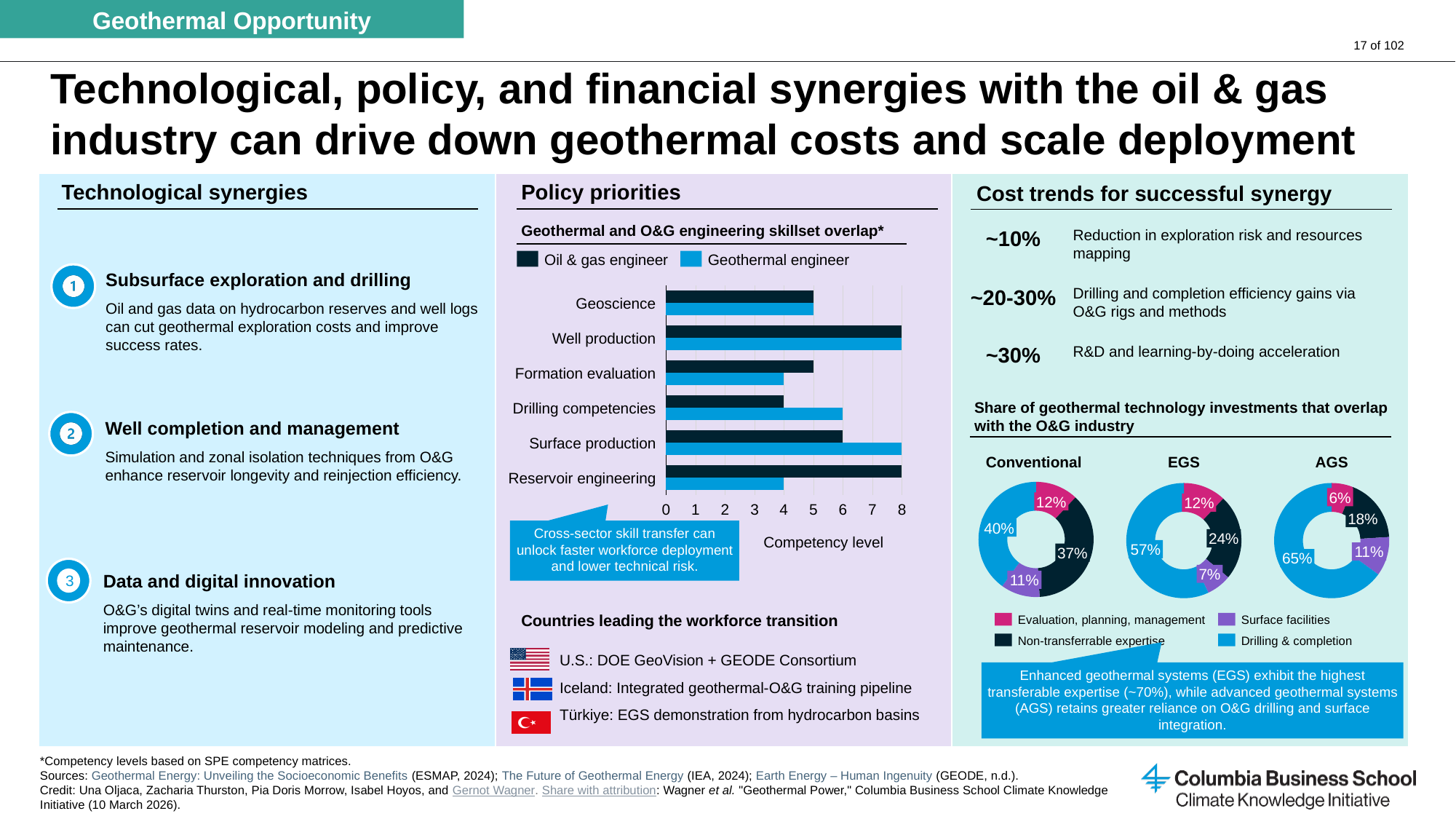
In the EGS donut chart, what share is Non-transferable expertise? 24% What is the difference between the Drilling & completion share in the AGS donut chart and in the Conventional donut chart? 25% In the 'Geothermal and O&G engineering skillset overlap' chart, what is the competency level for Oil & gas engineer in Reservoir engineering? 8 In the 'Geothermal and O&G engineering skillset overlap' chart, how many series does the legend list? 2 In the AGS donut chart, which category has the smallest share? Evaluation, planning, management In the 'Geothermal and O&G engineering skillset overlap' chart, how many competency categories are shown? 6 In the 'Geothermal and O&G engineering skillset overlap' chart, is the Oil & gas engineer value for Drilling competencies greater or less than 5? less In the 'Geothermal and O&G engineering skillset overlap' chart, what is the competency level for Geothermal engineer in Drilling competencies? 6 In the Conventional donut chart, what share is Drilling & completion? 40% What kind of chart is the 'Geothermal and O&G engineering skillset overlap' chart? bar chart In the AGS donut chart, which category has the largest share? Drilling & completion In the 'Geothermal and O&G engineering skillset overlap' chart, which is larger for Surface production: Oil & gas engineer or Geothermal engineer? Geothermal engineer